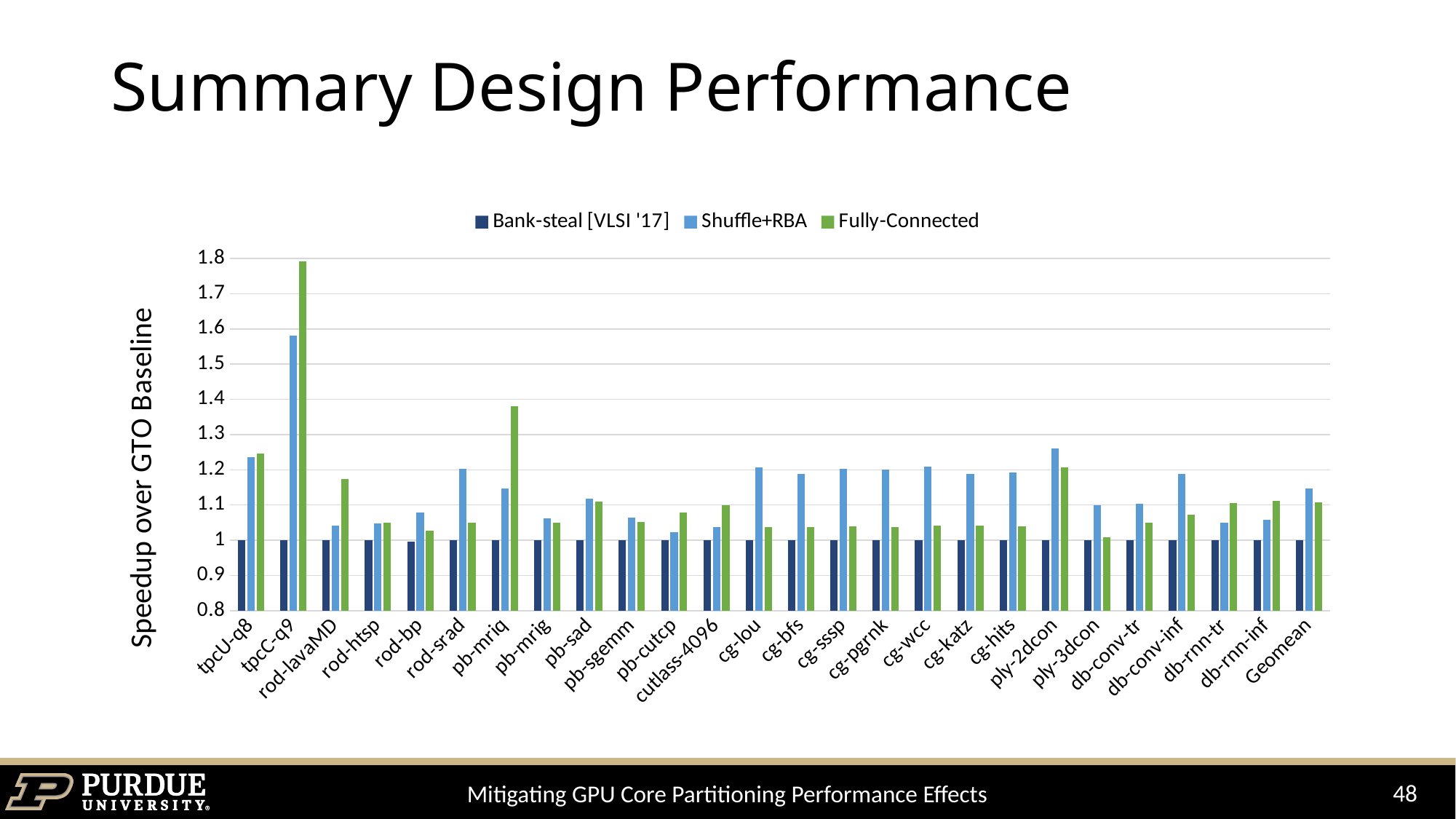
For ply-2dcon, which is larger: the Shuffle+RBA value or the Fully-Connected value? Shuffle+RBA How many categories are shown along the x axis? 26 Is the Fully-Connected value for cg-bfs greater or less than 1.1? less Is the Fully-Connected value for pb-mriq greater or less than 1.3? greater How many series does the legend list? 3 Which category has the highest Fully-Connected speedup? tpcC-q9 For rod-lavaMD, which is larger: the Shuffle+RBA value or the Fully-Connected value? Fully-Connected Is the Fully-Connected value for tpcC-q9 greater or less than 1.7? greater Which category has the highest Shuffle+RBA speedup? tpcC-q9 What is the label of the y axis? Speedup over GTO Baseline What kind of chart is shown on the slide? bar chart